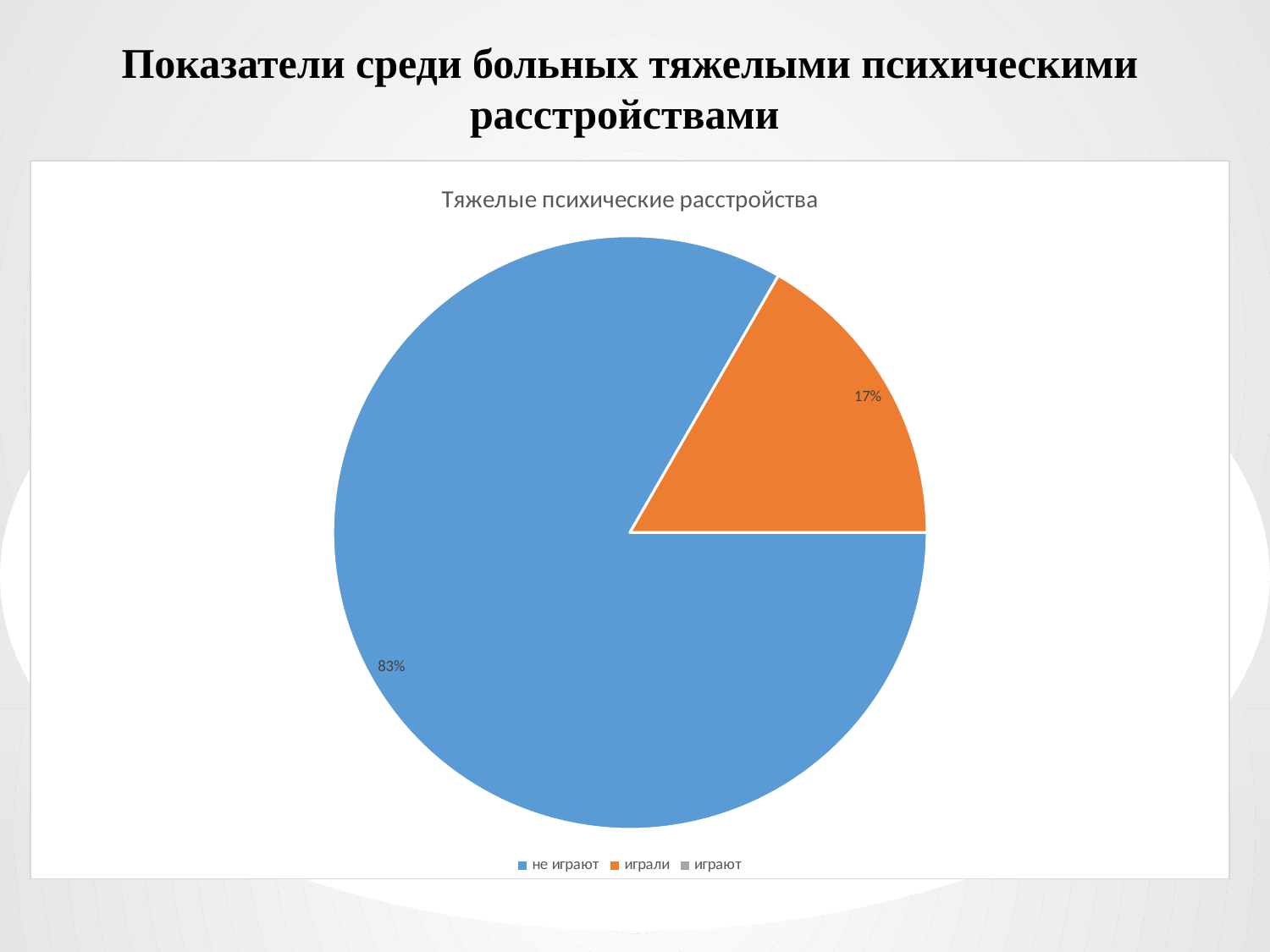
Which of the two visible slices is larger, "не играют" or "играли"? не играют What kind of chart is shown on the slide? pie chart What is the title of the chart? Тяжелые психические расстройства Is the share for "играли" greater or less than 50%? less How many entries does the legend list? 3 Is the share for "не играют" greater or less than 50%? greater Which category has the largest slice of the pie? не играют What share of the pie is labelled "не играют"? 83% What colour is the "играли" slice? orange What share of the pie is labelled "играли"? 17% What is the difference in percentage points between the "не играют" slice and the "играли" slice? 66